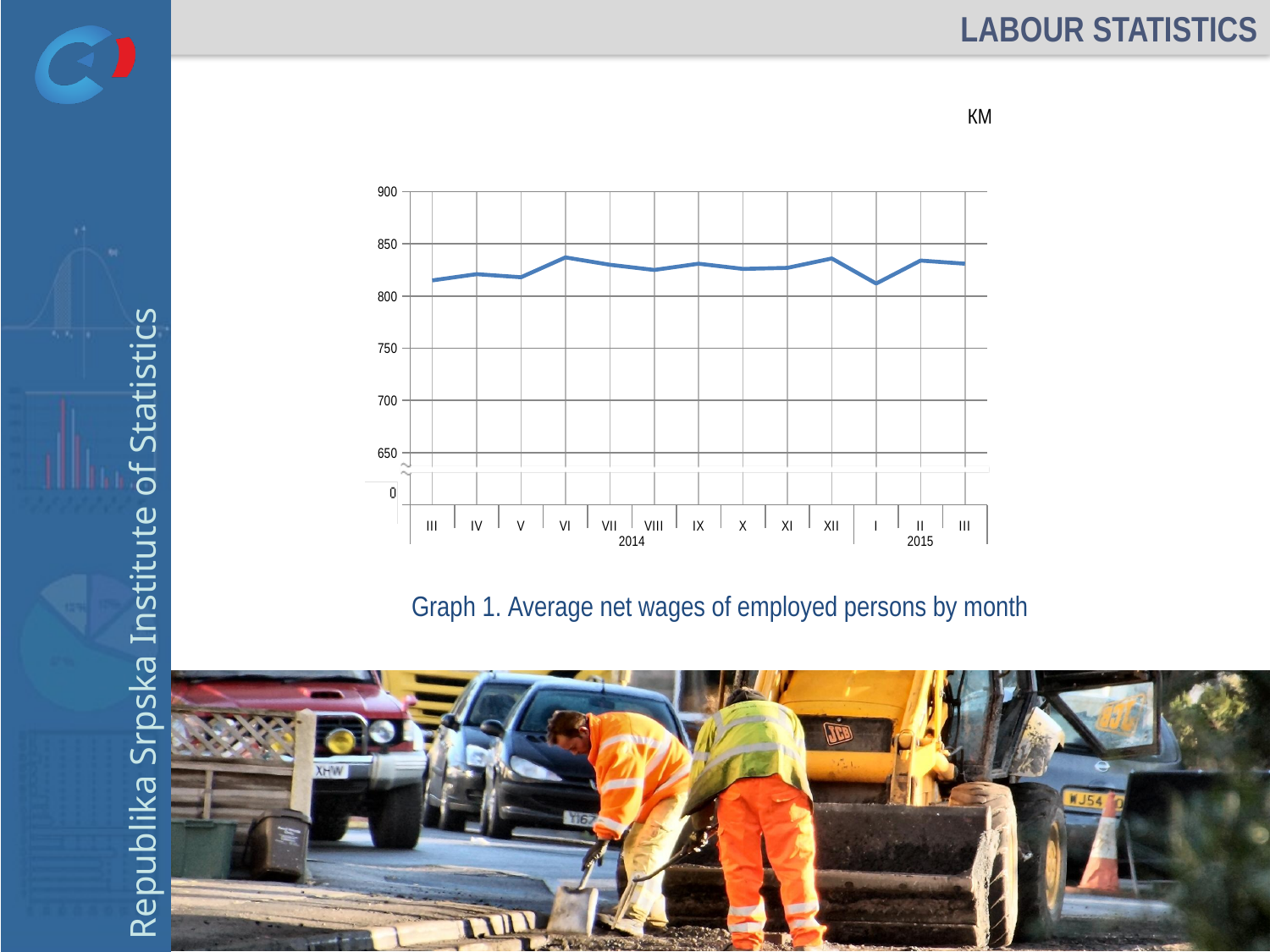
How many monthly data points are plotted on the chart? 13 Does the value rise or fall from XII 2014 to I 2015? fall Is the value for XII 2014 greater or less than 800? greater Is the value for III 2014 greater or less than 850? less Which is larger, the value for V 2014 or the value for VI 2014? VI 2014 What unit is shown above the chart for the plotted values? KM Is the value for VI 2014 greater or less than 800? greater What is the title of the chart on the slide? Graph 1. Average net wages of employed persons by month Does the value rise or fall from I 2015 to II 2015? rise What kind of chart is Graph 1? line chart Which is larger, the value for VI 2014 or the value for I 2015? VI 2014